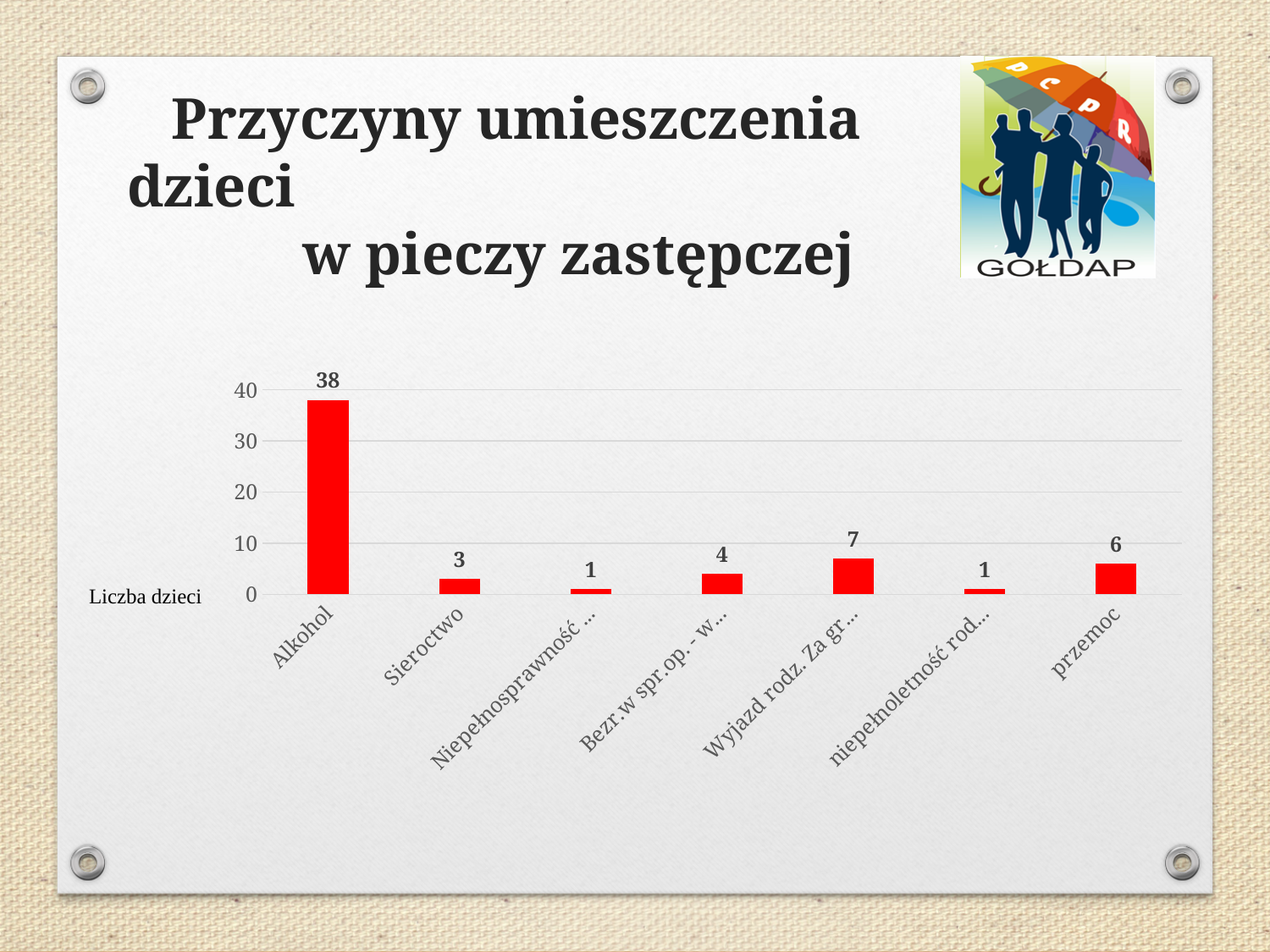
How many categories are shown on the x axis? 7 What is the value for the category beginning "Bezr.w spr.op."? 4 What label is shown next to the vertical axis of the chart? Liczba dzieci What is the value for przemoc? 6 What is the value for Alkohol? 38 What is the difference between the values for Alkohol and przemoc? 32 What is the value for the category beginning "Wyjazd rodz."? 7 Which category has the highest value? Alkohol What is the difference between the values for the category beginning "Wyjazd rodz." and Sieroctwo? 4 What is the value for Sieroctwo? 3 Which is larger, the value for przemoc or the value for Sieroctwo? przemoc What kind of chart is shown on the slide? bar chart